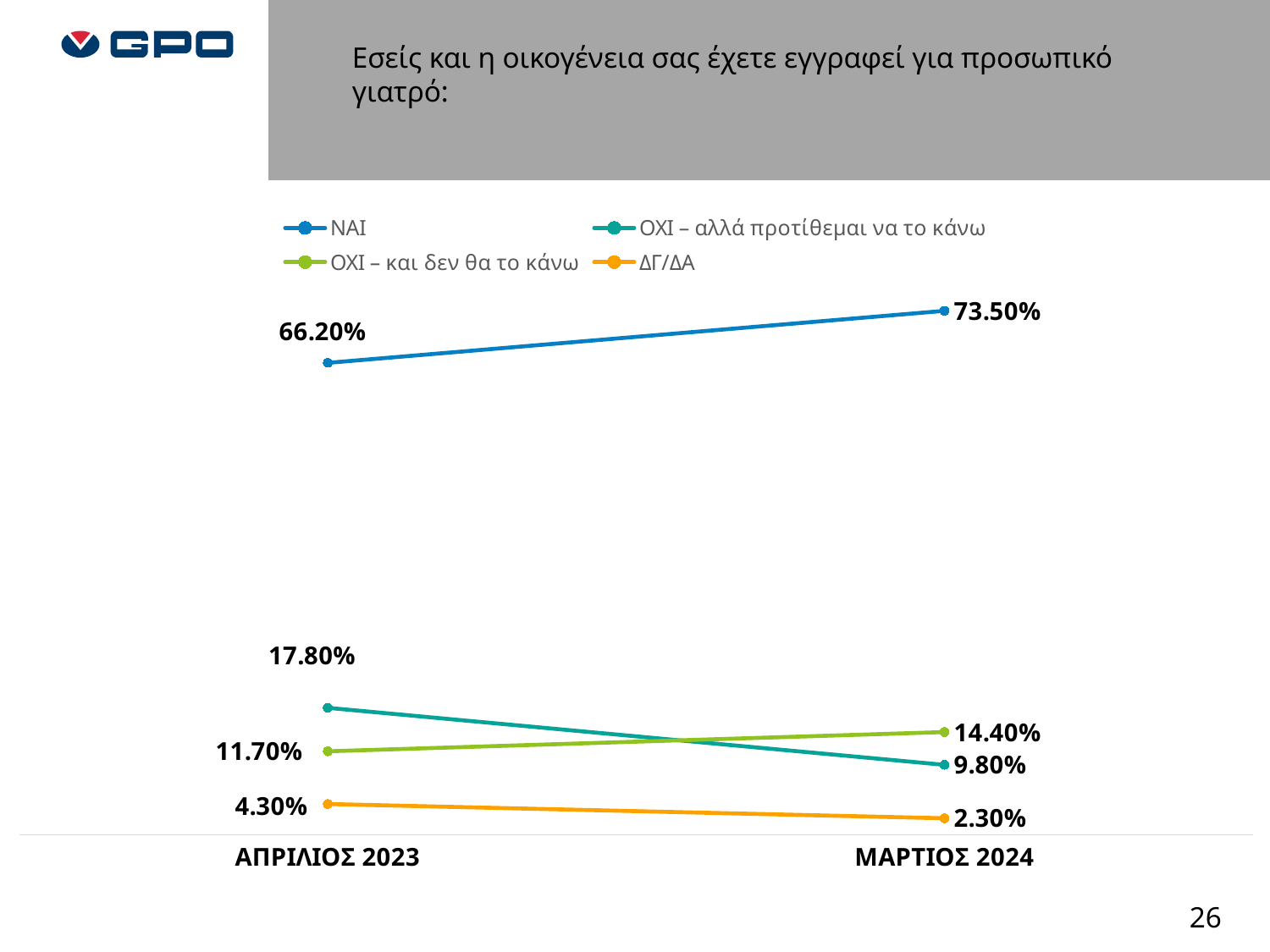
Which series has the lowest value in ΑΠΡΙΛΙΟΣ 2023? ΔΓ/ΔΑ What is the value for ΟΧΙ – αλλά προτίθεμαι να το κάνω in ΑΠΡΙΛΙΟΣ 2023? 17.80% What is the value for ΝΑΙ in ΜΑΡΤΙΟΣ 2024? 73.50% How many time points are shown on the x axis? 2 What is the value for ΔΓ/ΔΑ in ΜΑΡΤΙΟΣ 2024? 2.30% Does the value for ΟΧΙ – αλλά προτίθεμαι να το κάνω rise or fall from ΑΠΡΙΛΙΟΣ 2023 to ΜΑΡΤΙΟΣ 2024? fall How many series does the legend list? 4 In ΜΑΡΤΙΟΣ 2024, which is larger: ΟΧΙ – και δεν θα το κάνω or ΟΧΙ – αλλά προτίθεμαι να το κάνω? ΟΧΙ – και δεν θα το κάνω By how much did the value for ΝΑΙ change from ΑΠΡΙΛΙΟΣ 2023 to ΜΑΡΤΙΟΣ 2024? 7.30% Which series has the highest value in ΜΑΡΤΙΟΣ 2024? ΝΑΙ What is the value for ΝΑΙ in ΑΠΡΙΛΙΟΣ 2023? 66.20% What kind of chart is shown on the slide? line chart